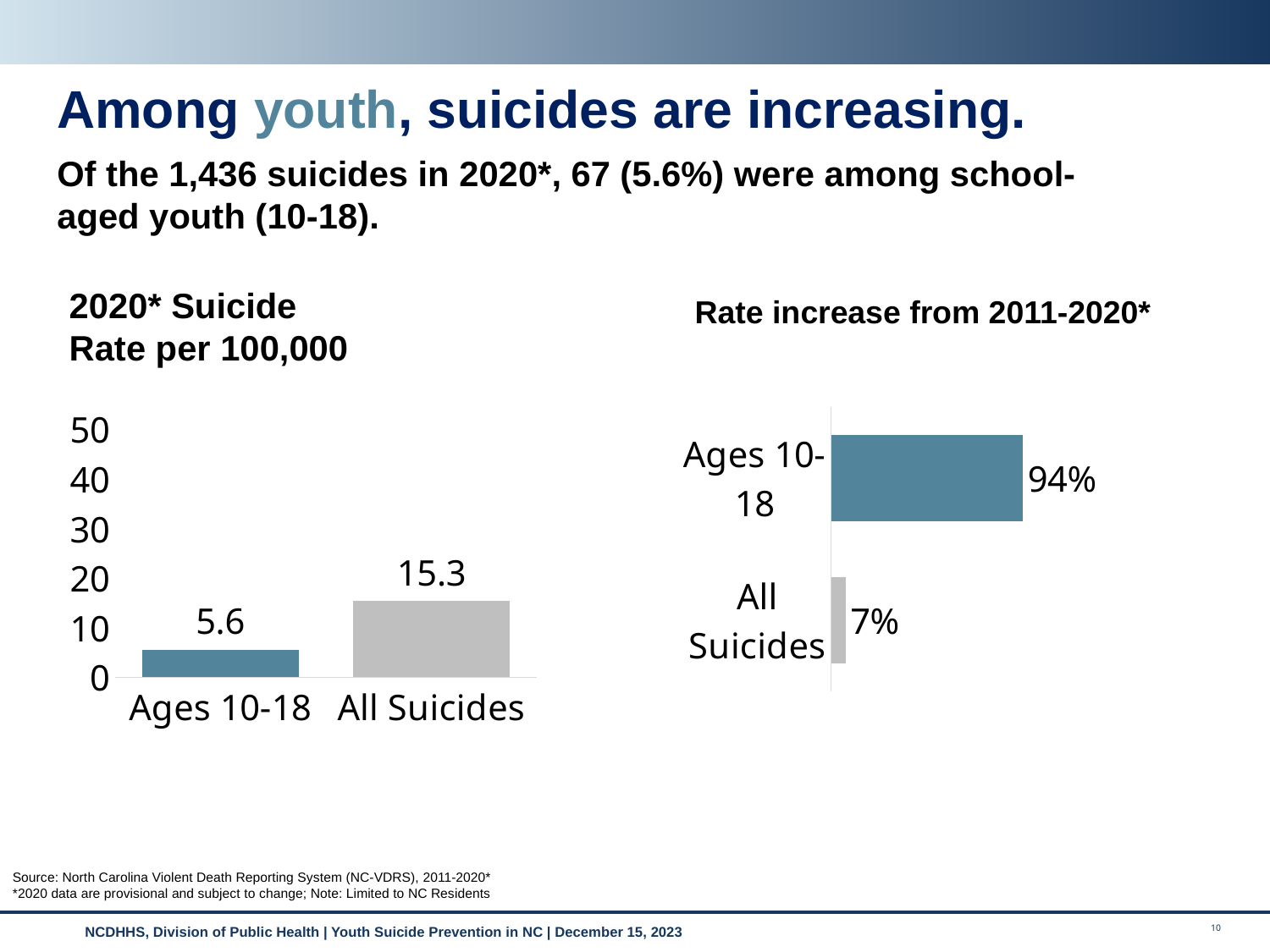
In the '2020* Suicide Rate per 100,000' chart, what is the value for Ages 10-18? 5.6 In the 'Rate increase from 2011-2020*' chart, what is the value for Ages 10-18? 94% In the '2020* Suicide Rate per 100,000' chart, is the value for All Suicides greater or less than 20? less In the '2020* Suicide Rate per 100,000' chart, what is the difference between All Suicides and Ages 10-18? 9.7 In the 'Rate increase from 2011-2020*' chart, which is larger: Ages 10-18 or All Suicides? Ages 10-18 In the 'Rate increase from 2011-2020*' chart, what is the difference between Ages 10-18 and All Suicides? 87% In the 'Rate increase from 2011-2020*' chart, which category has the lower value? All Suicides What kind of chart is the 'Rate increase from 2011-2020*' chart? Bar chart How many categories are shown in the '2020* Suicide Rate per 100,000' chart? 2 In the '2020* Suicide Rate per 100,000' chart, which category has the higher value? All Suicides In the '2020* Suicide Rate per 100,000' chart, what is the value for All Suicides? 15.3 In the 'Rate increase from 2011-2020*' chart, what is the value for All Suicides? 7%